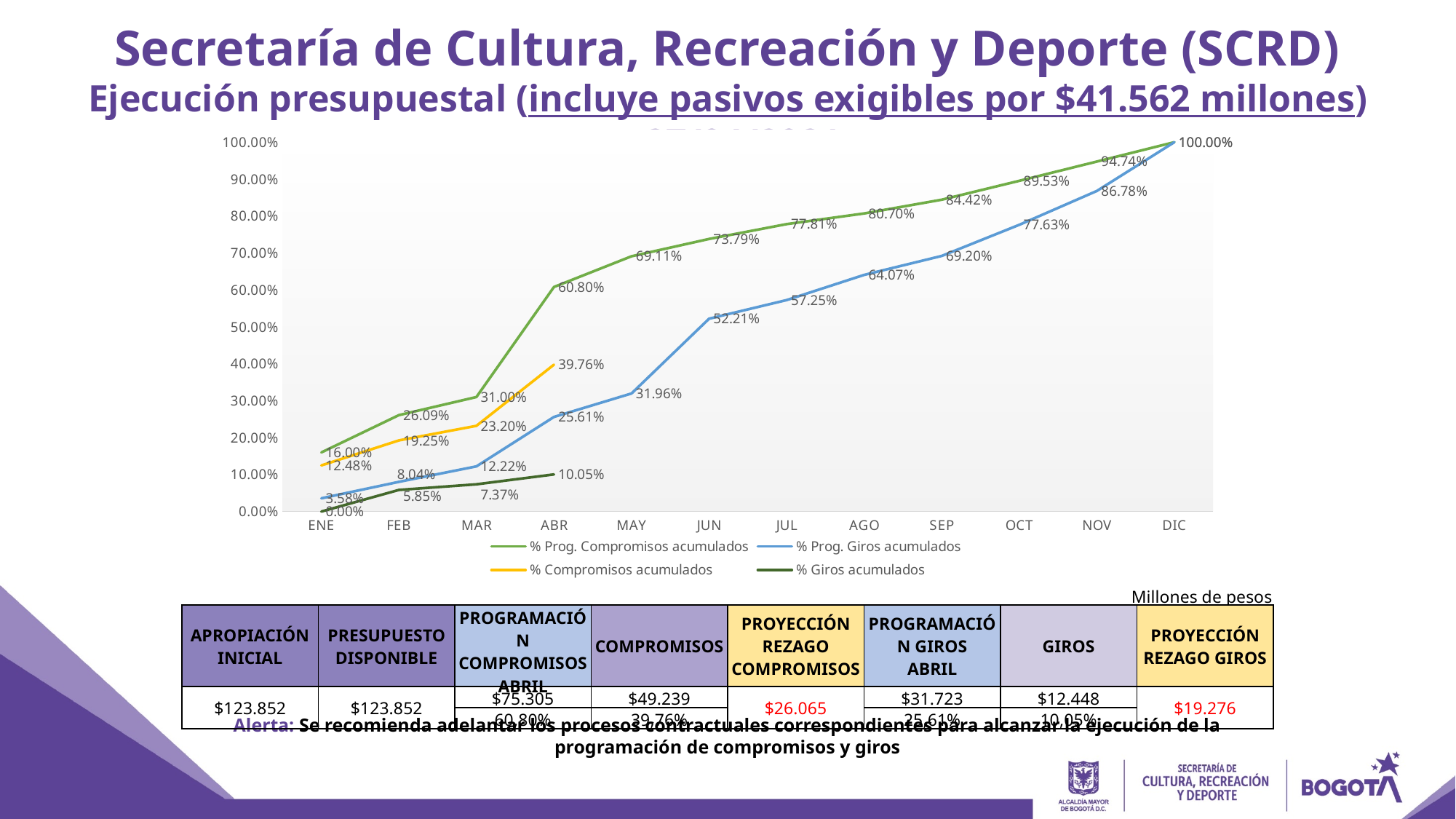
In which month is % Prog. Giros acumulados lowest? ENE What is the value of % Prog. Compromisos acumulados in ABR? 60.80% What is the value of % Giros acumulados in MAR? 7.37% What type of chart is shown on the slide? line chart What is the difference between % Prog. Compromisos acumulados and % Compromisos acumulados in ABR? 21.04% What is the value of % Prog. Giros acumulados in JUN? 52.21% Does % Prog. Compromisos acumulados rise or fall from ENE to DIC? rise Which is larger in FEB: % Prog. Giros acumulados or % Giros acumulados? % Prog. Giros acumulados Which colour is used for the % Compromisos acumulados line? yellow What is the value of % Compromisos acumulados in ABR? 39.76% How many series does the chart legend list? 4 How many months are shown on the x axis of the chart? 12